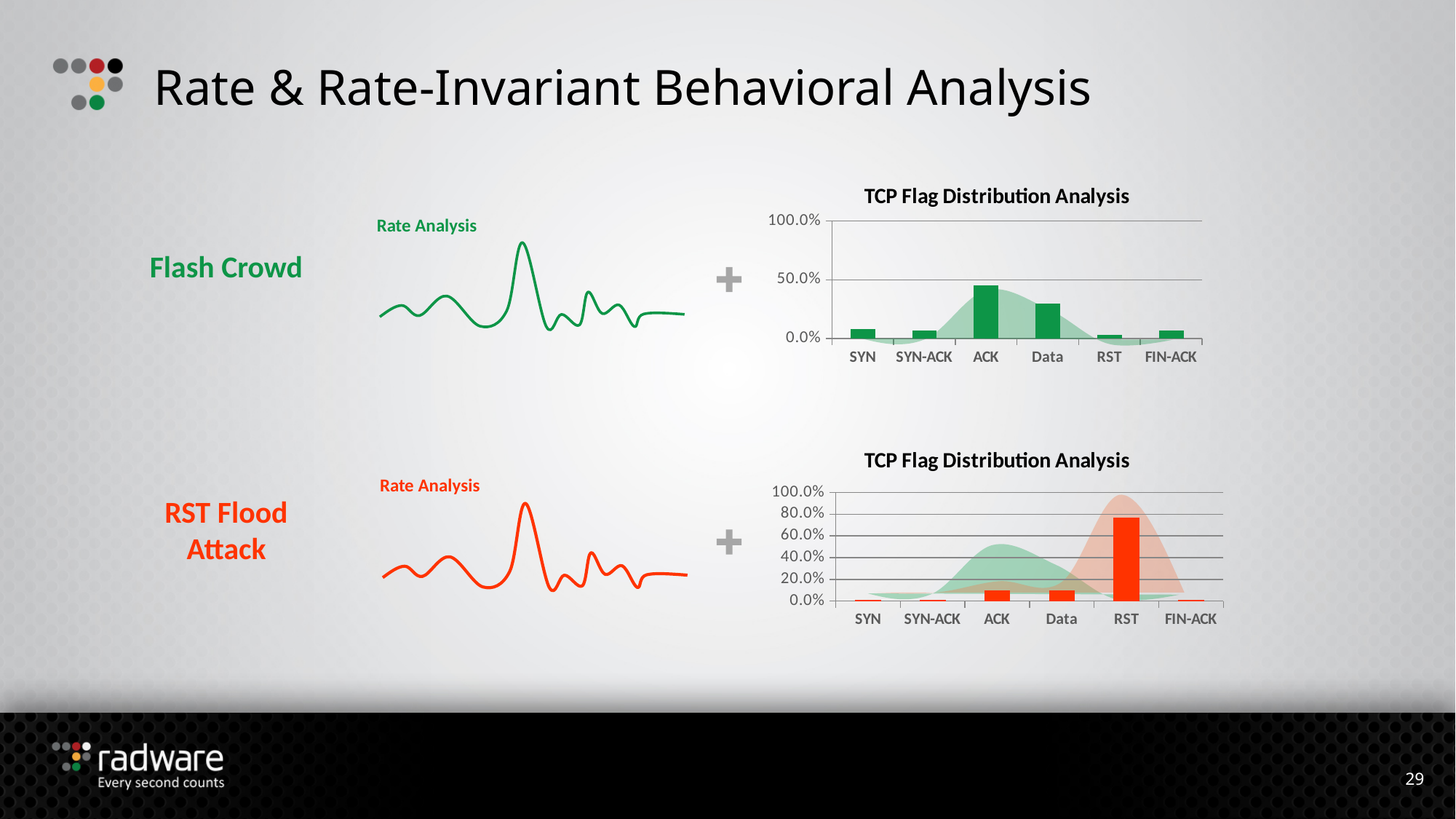
What colour are the bars in the bottom TCP Flag Distribution Analysis chart (RST Flood Attack)? orange-red In the top TCP Flag Distribution Analysis chart (Flash Crowd), which category has the lowest value? RST In the bottom TCP Flag Distribution Analysis chart (RST Flood Attack), which is larger, RST or ACK? RST What is the title of the bar chart next to RST Flood Attack? TCP Flag Distribution Analysis In the bottom TCP Flag Distribution Analysis chart (RST Flood Attack), which category has the highest value? RST How many categories are shown on the x axis of the top TCP Flag Distribution Analysis chart? 6 In the top TCP Flag Distribution Analysis chart (Flash Crowd), which is larger, ACK or Data? ACK What kind of chart is the top TCP Flag Distribution Analysis chart? bar chart In the bottom TCP Flag Distribution Analysis chart (RST Flood Attack), is the value for RST greater or less than 60.0%? greater In the top TCP Flag Distribution Analysis chart (Flash Crowd), is the value for ACK greater or less than 50.0%? less In the top TCP Flag Distribution Analysis chart (Flash Crowd), which category has the highest value? ACK In the bottom TCP Flag Distribution Analysis chart (RST Flood Attack), is the value for ACK greater or less than 20.0%? less